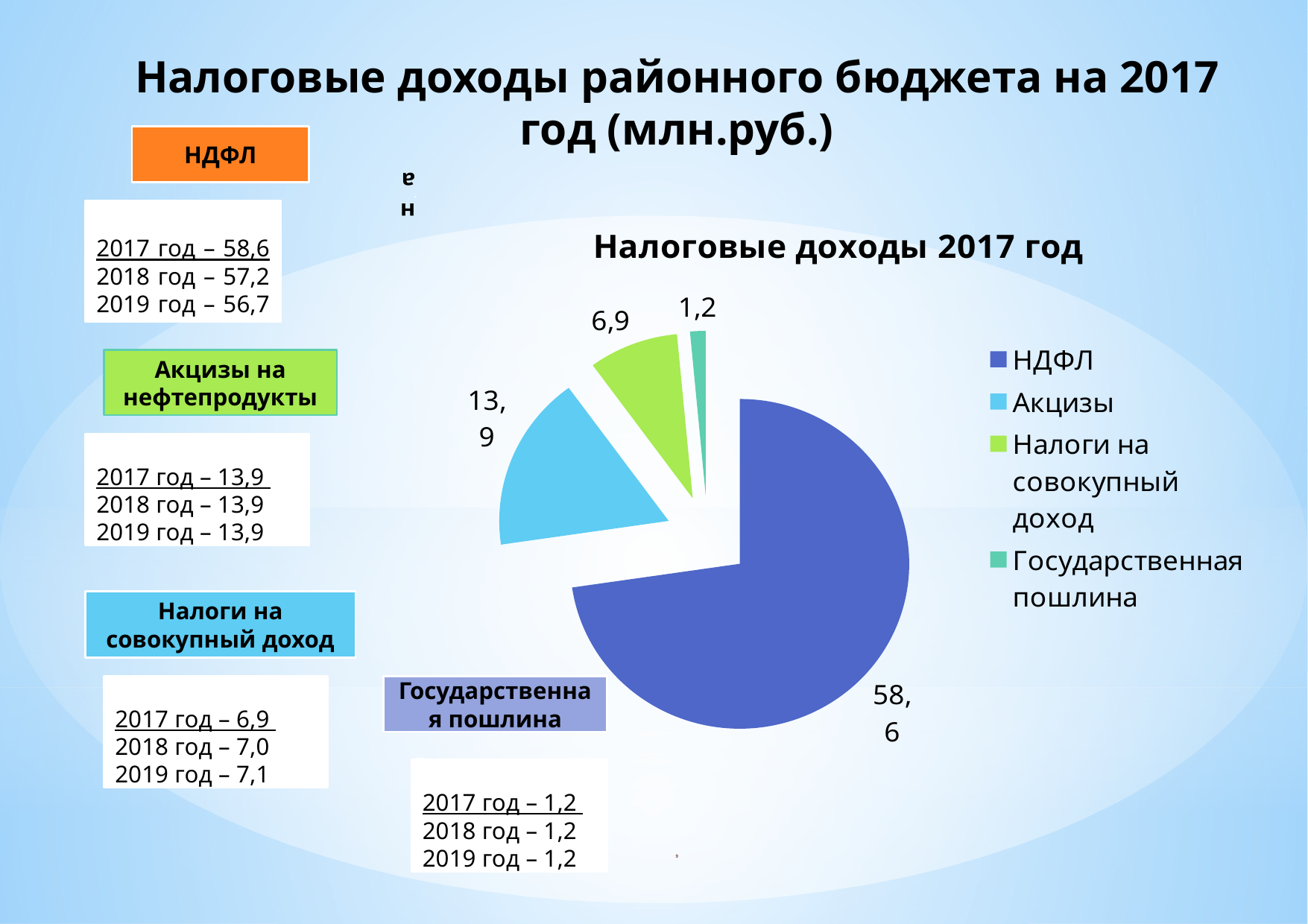
What is the value for Государственная пошлина in the pie chart? 1,2 What is the value for НДФЛ in the pie chart? 58,6 What is the total of all slices in the pie chart? 80,6 What is the value for Налоги на совокупный доход in the pie chart? 6,9 How many slices does the pie chart have? 4 What is the title of the chart on the slide? Налоговые доходы 2017 год Which is larger in the pie chart: Акцизы or Налоги на совокупный доход? Акцизы Which category has the largest slice in the pie chart? НДФЛ What is the difference between the values for НДФЛ and Акцизы in the pie chart? 44,7 What type of chart is shown on the slide? Pie chart What is the value for Акцизы in the pie chart? 13,9 Which category has the smallest slice in the pie chart? Государственная пошлина